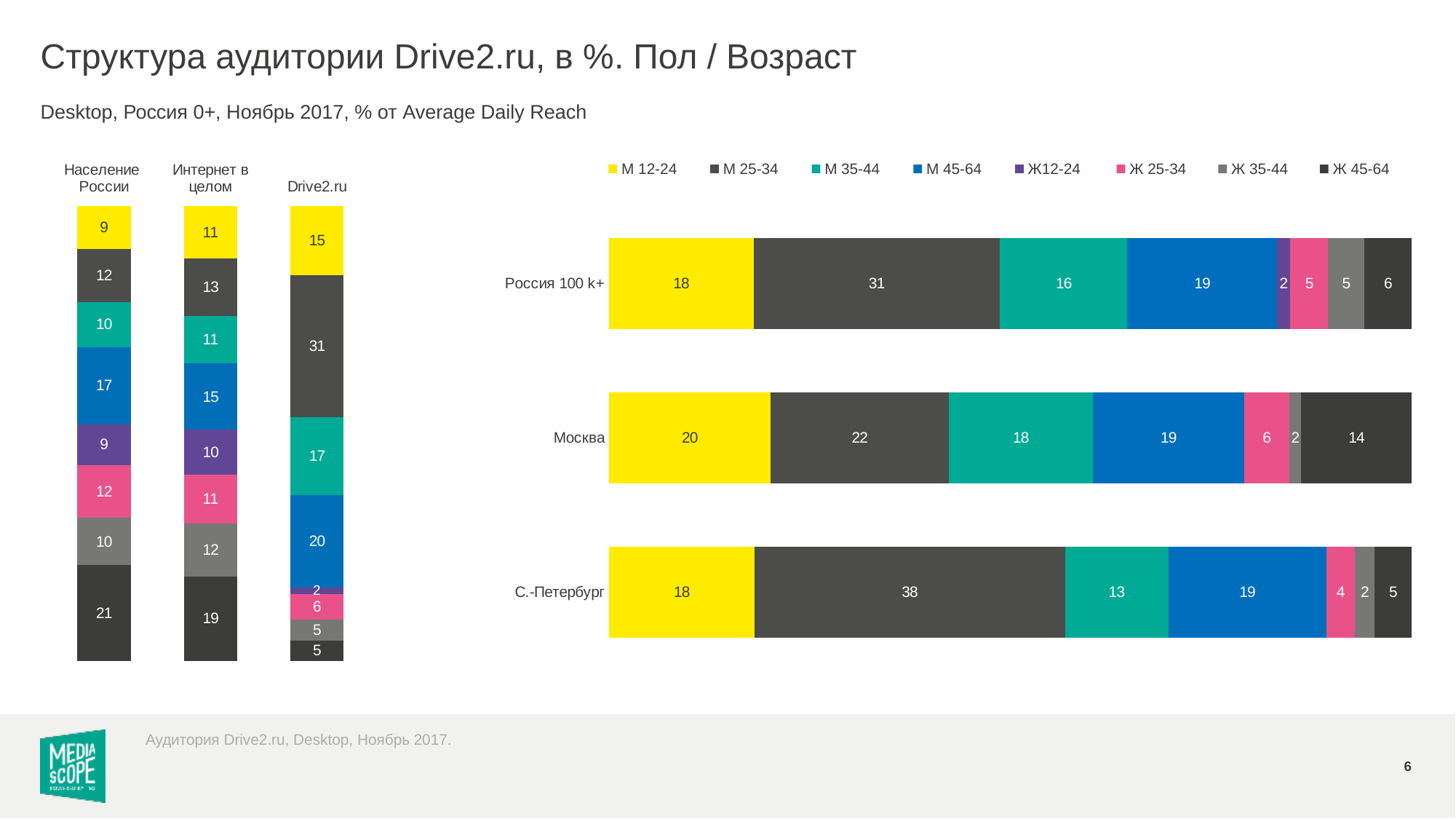
In the right chart, what is the value for М 25-34 in С.-Петербург? 38 In the right chart, what is the value for Ж 45-64 in Москва? 14 In the right chart, which is larger: the М 12-24 value for Москва or for Россия 100 k+? Москва How many series does the legend on the slide list? 8 In the right chart, which region has the highest value for М 25-34? С.-Петербург In the right chart, what is the difference between the М 25-34 values for С.-Петербург and Москва? 16 In the left chart, what is the difference between the М 45-64 values for Drive2.ru and Население России? 3 In the left chart, which column has the largest М 25-34 value? Drive2.ru In the left chart, what is the value for Ж 45-64 in the Население России column? 21 In the right chart, how many regions are plotted? 3 What kind of chart is the left chart? Stacked bar chart In the left chart, what is the value for М 25-34 in the Drive2.ru column? 31